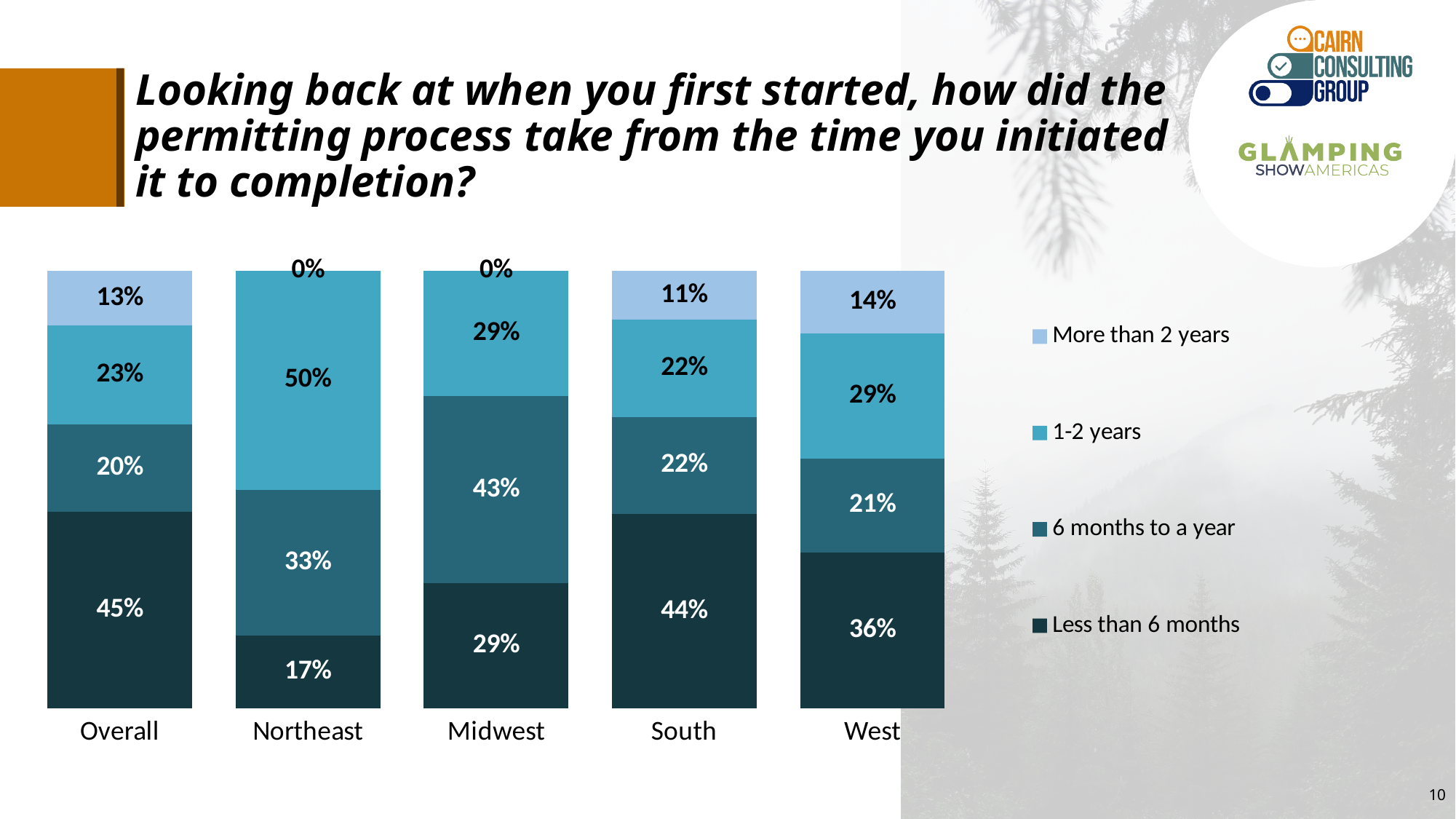
Which is larger: the 1-2 years value for the Midwest or for the South? Midwest What is the value for 6 months to a year in the Midwest? 43% What is the value for More than 2 years in the West? 14% What is the value for 1-2 years in the Northeast? 50% Which legend entry is shown in the darkest colour? Less than 6 months Which region has the highest value for Less than 6 months? South What is the difference between the Less than 6 months values for the South and the West? 8% How many regions or groups are shown on the x axis? 5 What kind of chart is shown on the slide? Stacked bar chart What percentage of Overall respondents reported the permitting process took less than 6 months? 45% Which region has the lowest value for Less than 6 months? Northeast How many series does the legend list? 4